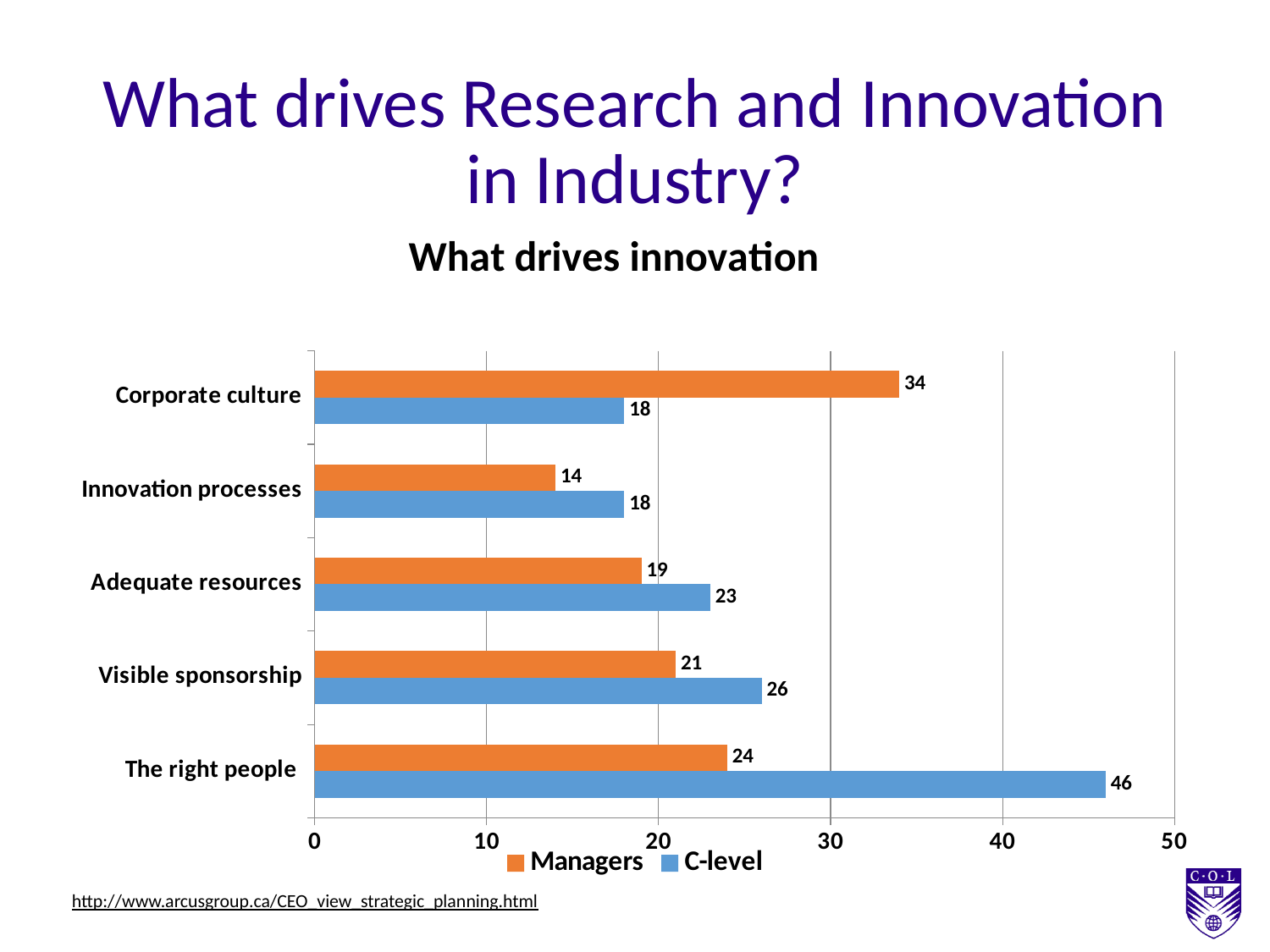
What kind of chart is shown on the slide? Bar chart What is the difference between the C-level and Managers values for The right people? 22 What is the C-level value for Adequate resources? 23 What is the title of the chart? What drives innovation How many series does the legend list? 2 What is the C-level value for The right people? 46 Is the Managers value for Corporate culture greater or less than 30? greater Which category has the highest C-level value? The right people Which category has the lowest Managers value? Innovation processes How many categories are shown in the chart? 5 For Visible sponsorship, which series has the larger value, Managers or C-level? C-level What is the Managers value for Corporate culture? 34